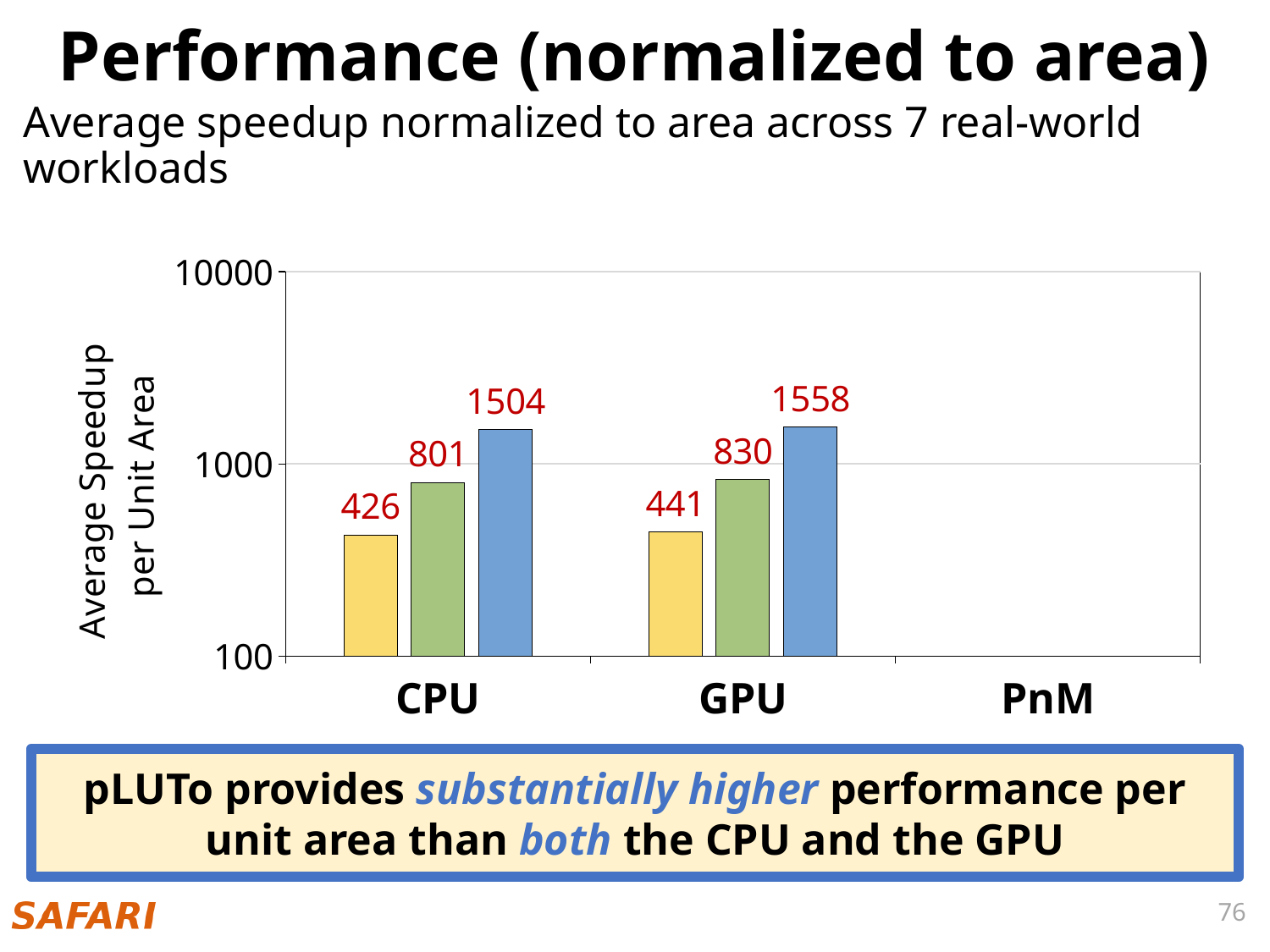
What is the label of the y axis? Average Speedup per Unit Area What is the difference between the green bar and the yellow bar for CPU? 375 What is the value of the yellow bar for CPU? 426 What is the value of the green bar for GPU? 830 Which is larger, the yellow bar for CPU or the yellow bar for GPU? GPU Is the value of the green bar for CPU greater or less than 1000? less What is the difference between the blue bar for GPU and the blue bar for CPU? 54 What kind of chart is shown on the slide? bar chart How many categories are labelled on the x axis? 3 What is the value of the blue bar for CPU? 1504 What is the value of the blue bar for GPU? 1558 Which category has the highest labelled bar on the chart? GPU